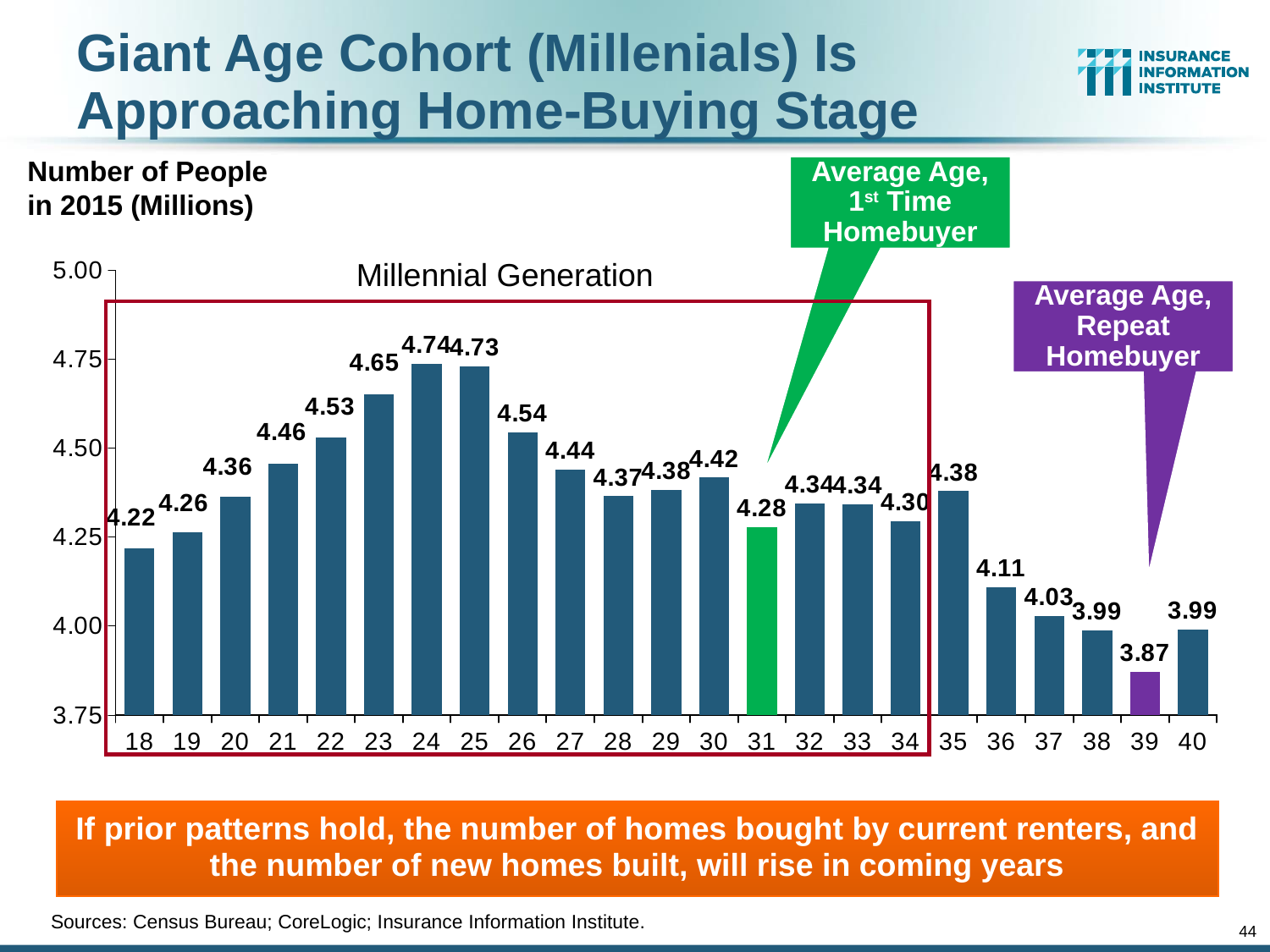
Which age has the lowest number of people? 39 How many ages are shown on the x axis? 23 What kind of chart is shown on the slide? bar chart Do the values rise or fall from age 35 to age 39? fall Which age has the highest number of people? 24 Which age has a larger value, 23 or 26? 23 Is the value for age 36 greater or less than 4.25? less What is the difference in millions between the values for age 24 and age 39? 0.87 According to the callout, which age is labelled as the average age of a repeat homebuyer? 39 What is the number of people (millions) for age 39, the bar highlighted in purple? 3.87 What is the number of people (millions) for age 31, the bar highlighted in green? 4.28 What is the number of people (millions) for age 24? 4.74